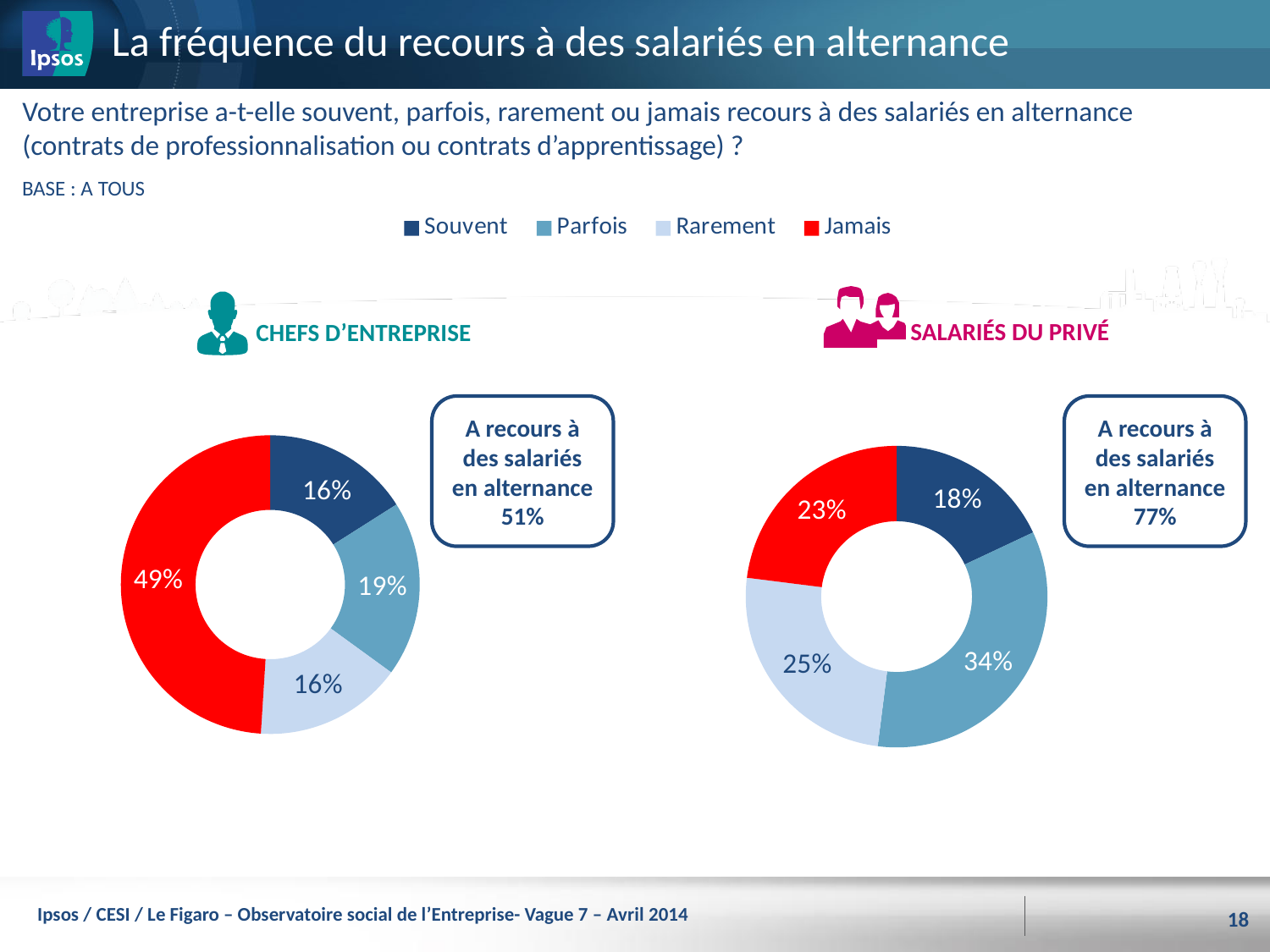
In the Chefs d'entreprise chart, what is the difference between the Jamais share and the Parfois share? 30 percentage points In the Chefs d'entreprise chart, which category has the largest share? Jamais In the Salariés du privé chart, what is the difference between the Parfois share and the Rarement share? 9 percentage points How many categories does the legend list? 4 In the Salariés du privé chart, which category has the largest share? Parfois Which chart shows a larger share for Jamais, Chefs d'entreprise or Salariés du privé? Chefs d'entreprise In the Chefs d'entreprise chart, what percentage is shown for Jamais? 49% In the Salariés du privé chart, which category has the smallest share? Souvent In the Salariés du privé chart, what percentage is shown for Souvent? 18% Which colour represents Jamais in the legend? Red In the Salariés du privé chart, what percentage is shown for Parfois? 34% What type of chart is used for the Chefs d'entreprise data? Donut (pie) chart